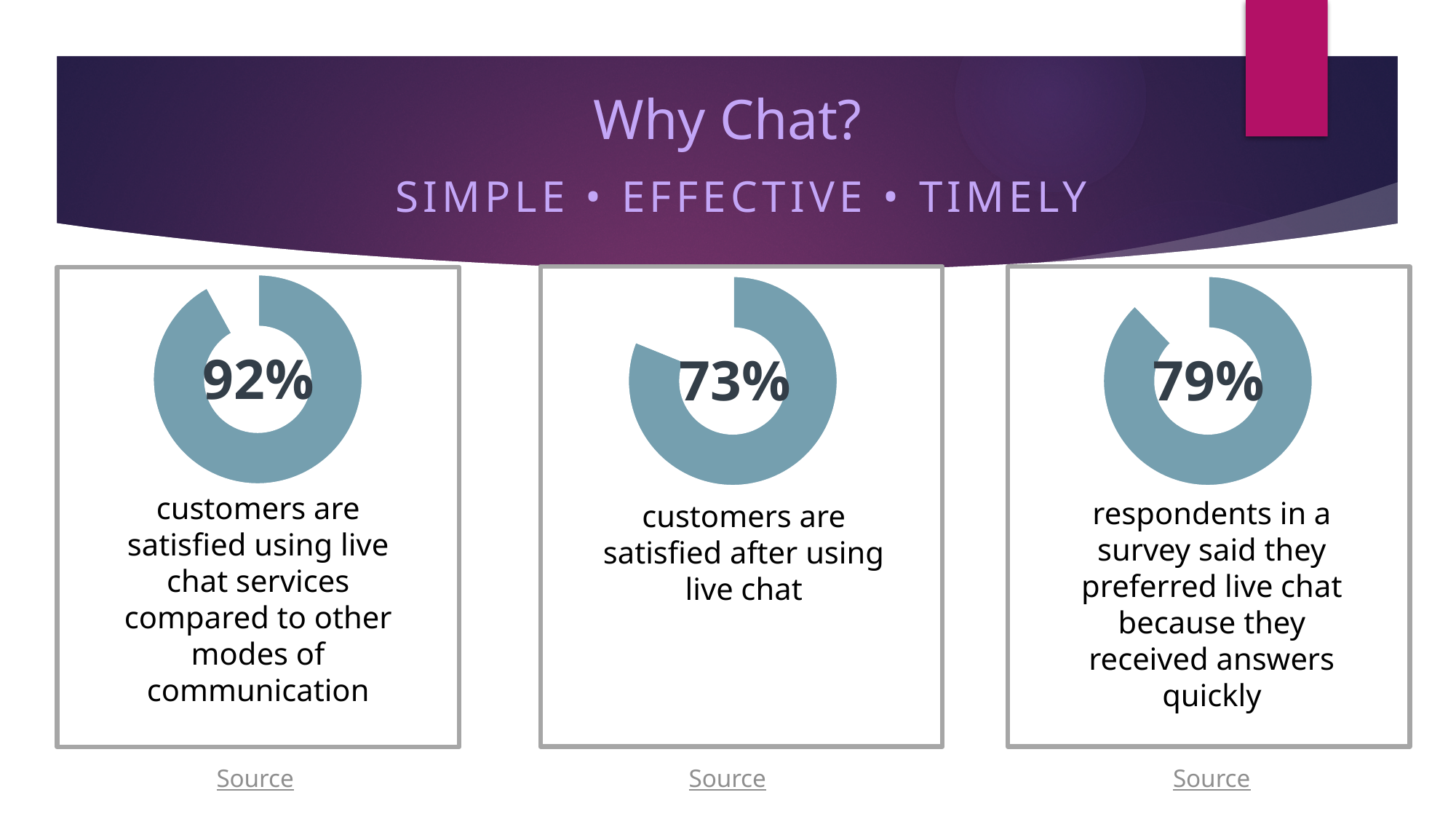
How many donut charts are shown on the slide? 3 What colour is the filled portion of the donut charts on the slide? Blue-grey (teal) What value is shown in the left donut chart (customers satisfied using live chat compared to other modes of communication)? 92% What value is shown in the middle donut chart (customers satisfied after using live chat)? 73% What value is shown in the right donut chart (respondents who preferred live chat because they received answers quickly)? 79% Which of the three donut charts on the slide shows the lowest percentage? The middle chart (73%) What is the difference between the percentage in the right donut chart and the percentage in the middle donut chart? 6% Is the percentage in the middle donut chart larger or smaller than the percentage in the right donut chart? Smaller Which of the three donut charts on the slide shows the highest percentage? The left chart (92%) What kind of chart is used to display each percentage on the slide? Donut (pie) chart What is the title of the slide containing the three donut charts? Why Chat? What is the difference between the percentage in the left donut chart and the percentage in the middle donut chart? 19%